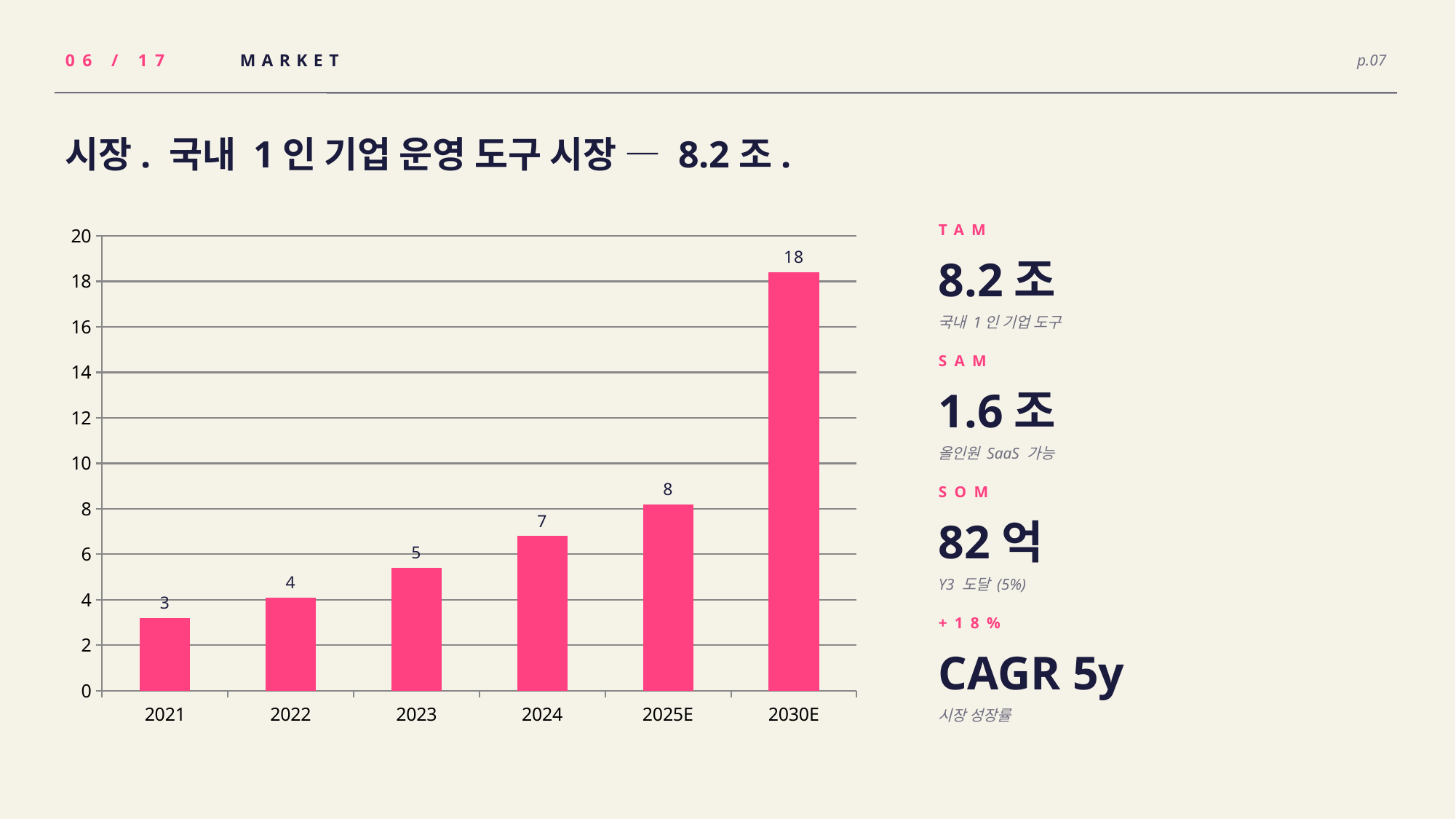
What kind of chart is shown on the slide? bar chart Is the value for 2030E greater or less than 16? greater What is the value shown for 2021? 3 Which year has the lowest value in the chart? 2021 What is the value shown for 2030E? 18 What is the value shown for 2024? 7 What is the difference between the labelled values for 2030E and 2025E? 10 Which is larger, the value for 2024 or the value for 2022? 2024 What is the value shown for 2025E? 8 Which year has the highest value in the chart? 2030E How many years (categories) are shown on the x axis? 6 What is the difference between the labelled values for 2023 and 2022? 1